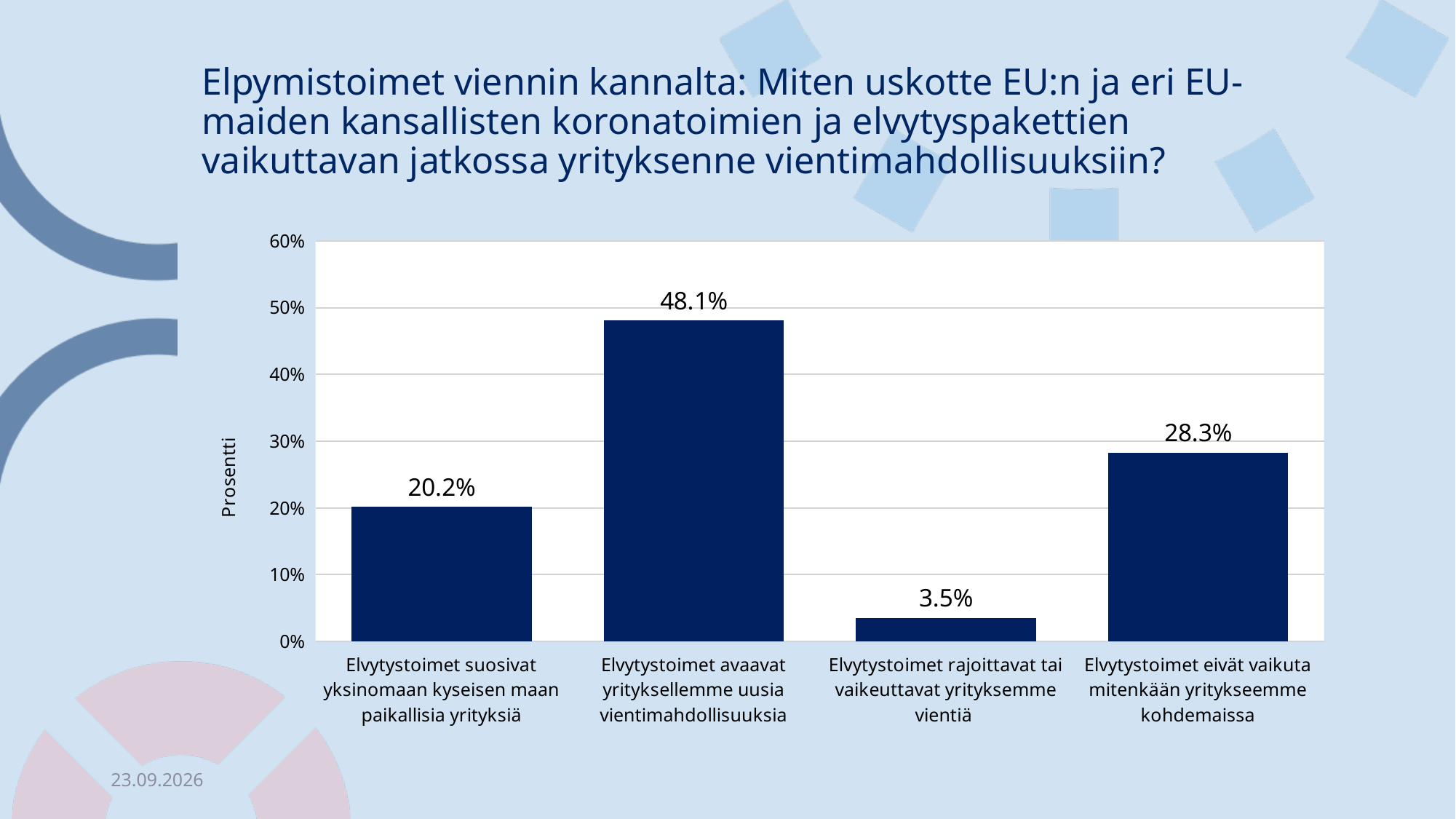
What is the difference between the values for "Elvytystoimet avaavat yrityksellemme uusia vientimahdollisuuksia" and "Elvytystoimet eivät vaikuta mitenkään yritykseemme kohdemaissa"? 19.8% Which category has the highest value? Elvytystoimet avaavat yrityksellemme uusia vientimahdollisuuksia What is the value for "Elvytystoimet suosivat yksinomaan kyseisen maan paikallisia yrityksiä"? 20.2% Is the value for "Elvytystoimet avaavat yrityksellemme uusia vientimahdollisuuksia" greater or less than 40%? greater What kind of chart is shown on the slide? Bar chart What is the value for "Elvytystoimet avaavat yrityksellemme uusia vientimahdollisuuksia"? 48.1% Which category has the lowest value? Elvytystoimet rajoittavat tai vaikeuttavat yrityksemme vientiä How many categories are shown in the chart? 4 What is the label of the vertical axis? Prosentti What is the value for "Elvytystoimet rajoittavat tai vaikeuttavat yrityksemme vientiä"? 3.5% Which is larger: the value for "Elvytystoimet suosivat yksinomaan kyseisen maan paikallisia yrityksiä" or for "Elvytystoimet eivät vaikuta mitenkään yritykseemme kohdemaissa"? Elvytystoimet eivät vaikuta mitenkään yritykseemme kohdemaissa What is the value for "Elvytystoimet eivät vaikuta mitenkään yritykseemme kohdemaissa"? 28.3%